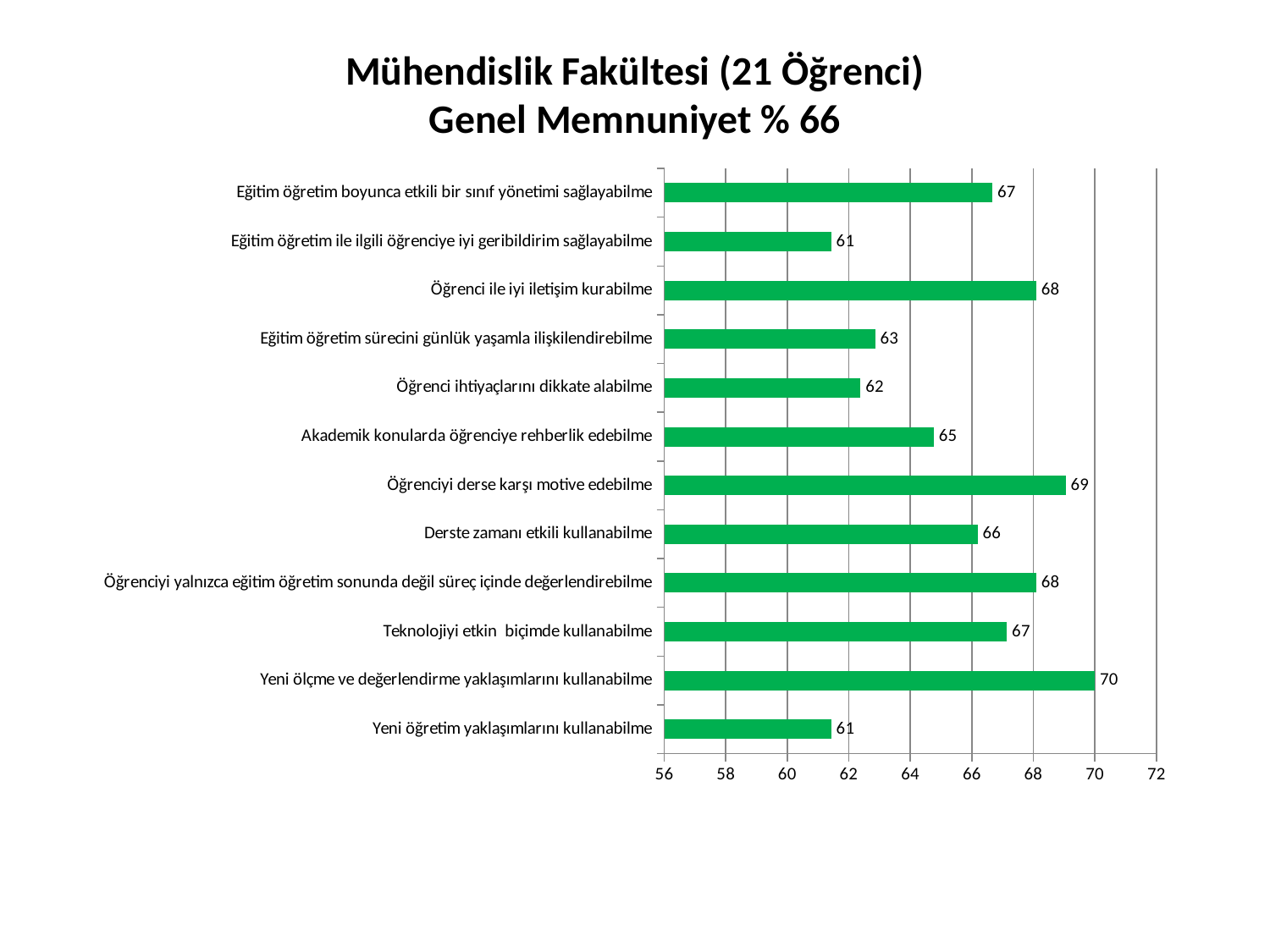
What is the value for "Derste zamanı etkili kullanabilme"? 66 Is the value for "Teknolojiyi etkin biçimde kullanabilme" greater or less than 64? greater What is the difference between the values for "Yeni ölçme ve değerlendirme yaklaşımlarını kullanabilme" and "Yeni öğretim yaklaşımlarını kullanabilme"? 9 Which category has the highest value? Yeni ölçme ve değerlendirme yaklaşımlarını kullanabilme What is the value for "Yeni ölçme ve değerlendirme yaklaşımlarını kullanabilme"? 70 What is the difference between the values for "Öğrenci ile iyi iletişim kurabilme" and "Eğitim öğretim ile ilgili öğrenciye iyi geribildirim sağlayabilme"? 7 Which is larger: the value for "Akademik konularda öğrenciye rehberlik edebilme" or the value for "Eğitim öğretim sürecini günlük yaşamla ilişkilendirebilme"? Akademik konularda öğrenciye rehberlik edebilme What is the value for "Öğrenciyi derse karşı motive edebilme"? 69 What is the title of the chart? Mühendislik Fakültesi (21 Öğrenci) Genel Memnuniyet % 66 What is the value for "Öğrenci ihtiyaçlarını dikkate alabilme"? 62 How many categories are shown in the chart? 12 What kind of chart is shown on the slide? bar chart